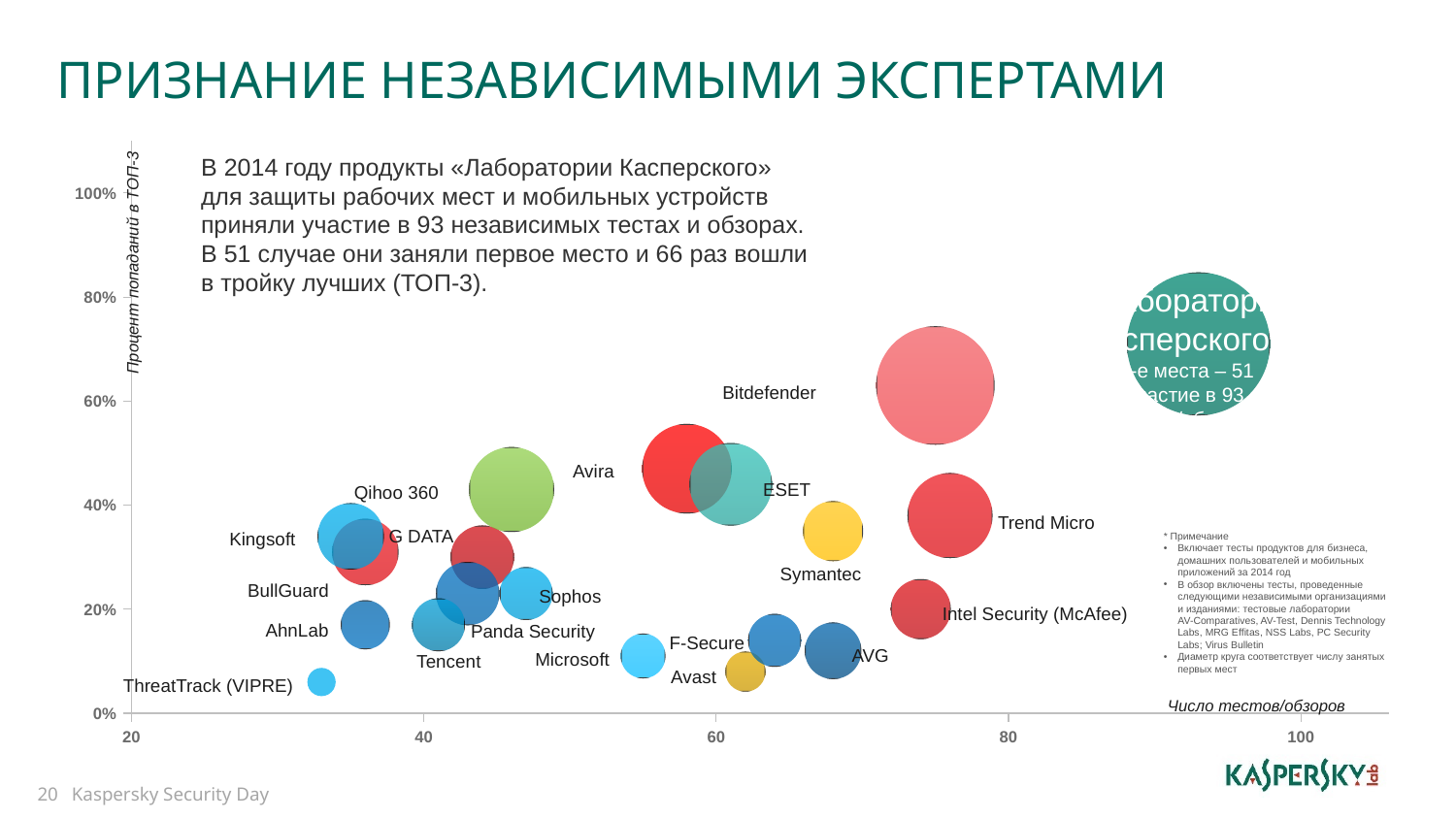
Is the percent of TOP-3 placements for Symantec greater or less than 40%? less How many independent tests and reviews did Kaspersky Lab products take part in, according to the slide? 93 Which vendor's bubble is furthest to the right, i.e. has the most tests/reviews? Лаборатория Касперского What kind of chart is shown on the slide? bubble chart How many first places did Kaspersky Lab products take in 2014, according to the slide? 51 Is the number of tests/reviews for Bitdefender greater or less than 80? less Is the percent of TOP-3 placements for Bitdefender greater or less than 40%? greater How many times did Kaspersky Lab products enter the top three (ТОП-3), according to the slide? 66 What is the label of the horizontal axis of the chart? Число тестов/обзоров Which vendor has the lowest percent of TOP-3 placements? ThreatTrack (VIPRE) Which has a higher percent of TOP-3 placements, Bitdefender or Avira? Bitdefender Which vendor has the highest percent of TOP-3 placements (Процент попаданий в ТОП-3)? Лаборатория Касперского